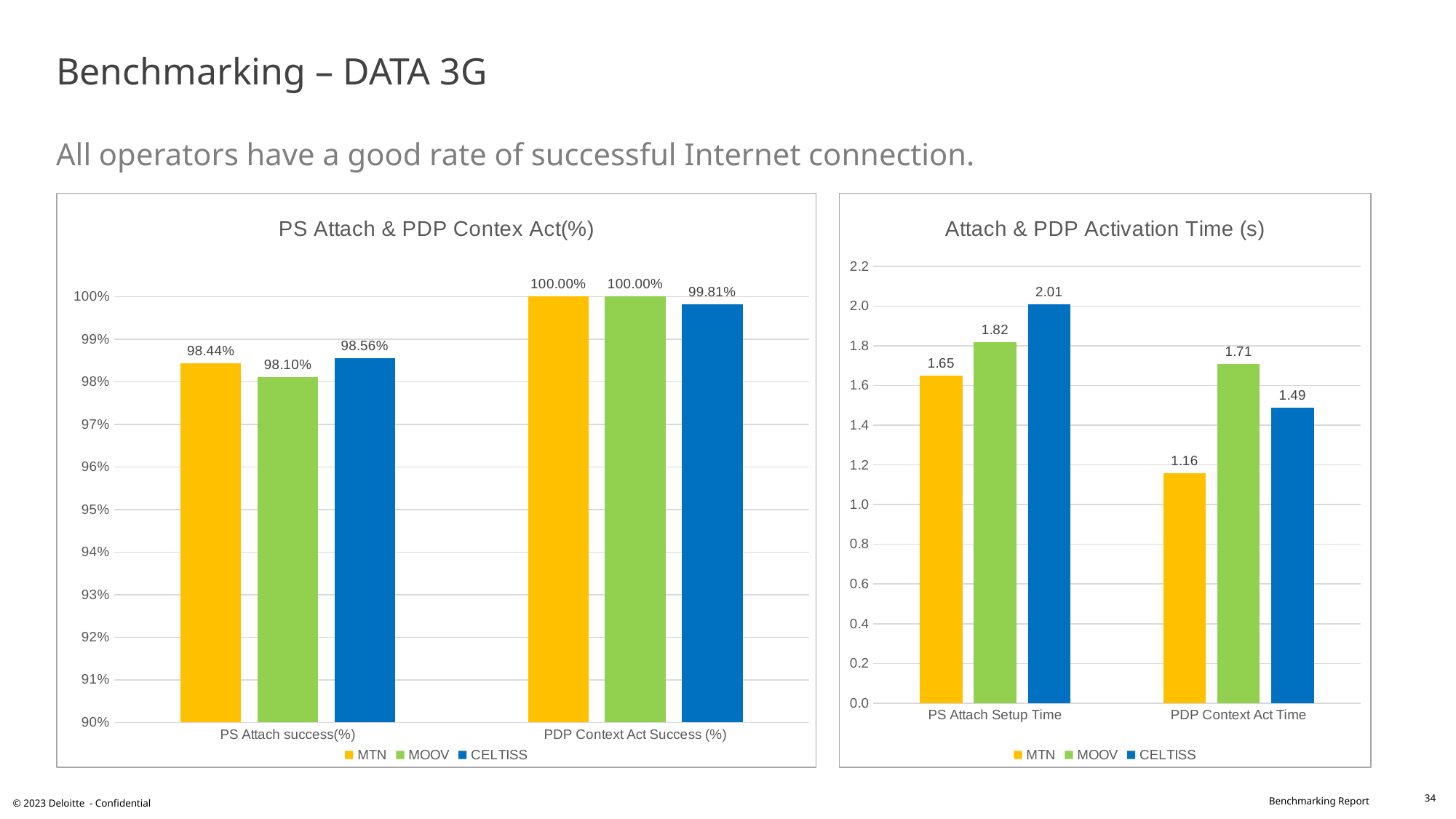
In the 'Attach & PDP Activation Time (s)' chart, how many categories are shown on the x axis? 2 In the 'PS Attach & PDP Contex Act(%)' chart, what is the difference between CELTISS and MOOV for PS Attach success(%)? 0.46% In the 'PS Attach & PDP Contex Act(%)' chart, what is the PDP Context Act Success (%) value for CELTISS? 99.81% In the 'Attach & PDP Activation Time (s)' chart, what is the difference between CELTISS and MTN for PS Attach Setup Time? 0.36 In the 'PS Attach & PDP Contex Act(%)' chart, which operator has the lowest PS Attach success(%)? MOOV In the 'Attach & PDP Activation Time (s)' chart, what is the PDP Context Act Time for MTN? 1.16 In the 'PS Attach & PDP Contex Act(%)' chart, what is the PS Attach success(%) value for MTN? 98.44% In the 'Attach & PDP Activation Time (s)' chart, what is the PS Attach Setup Time for CELTISS? 2.01 In the 'PS Attach & PDP Contex Act(%)' chart, how many series does the legend list? 3 In the 'Attach & PDP Activation Time (s)' chart, which operator has the highest PDP Context Act Time? MOOV In the 'Attach & PDP Activation Time (s)' chart, is the PS Attach Setup Time for MOOV larger or smaller than the PDP Context Act Time for MOOV? larger What kind of chart is the 'Attach & PDP Activation Time (s)' chart? bar chart